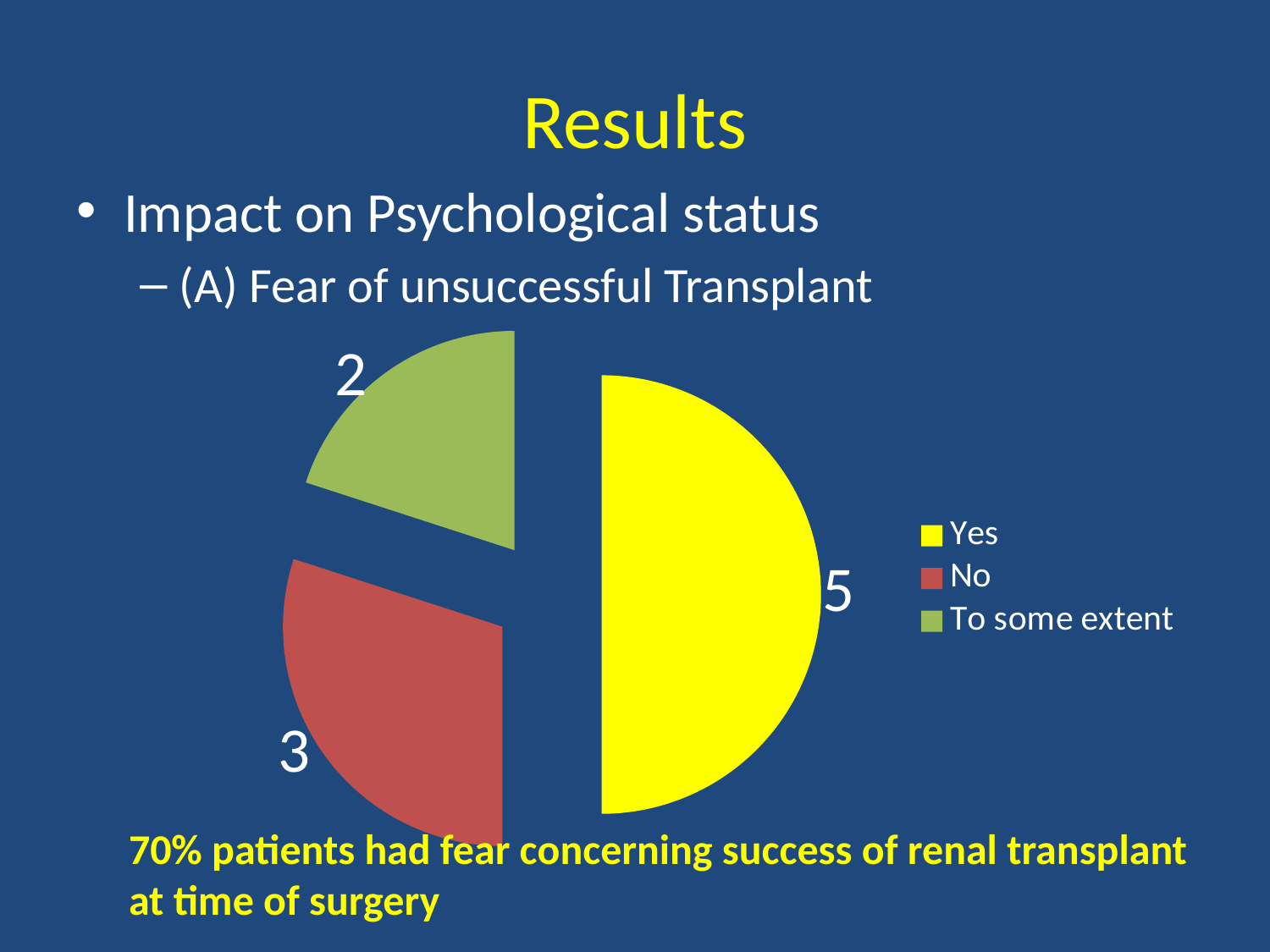
What is the value for the "Yes" slice? 5 Which category has the largest slice? Yes What is the value for the "No" slice? 3 How many slices does the pie chart have? 3 What is the difference between the "Yes" value and the "No" value? 2 Which is larger, the "No" slice or the "To some extent" slice? No What colour is the "No" slice in the pie chart? red What share of the pie does the "To some extent" slice represent? 20% What share of the pie does the "Yes" slice represent? 50% Which category has the smallest slice? To some extent What is the value for the "To some extent" slice? 2 What type of chart is shown on the slide? pie chart